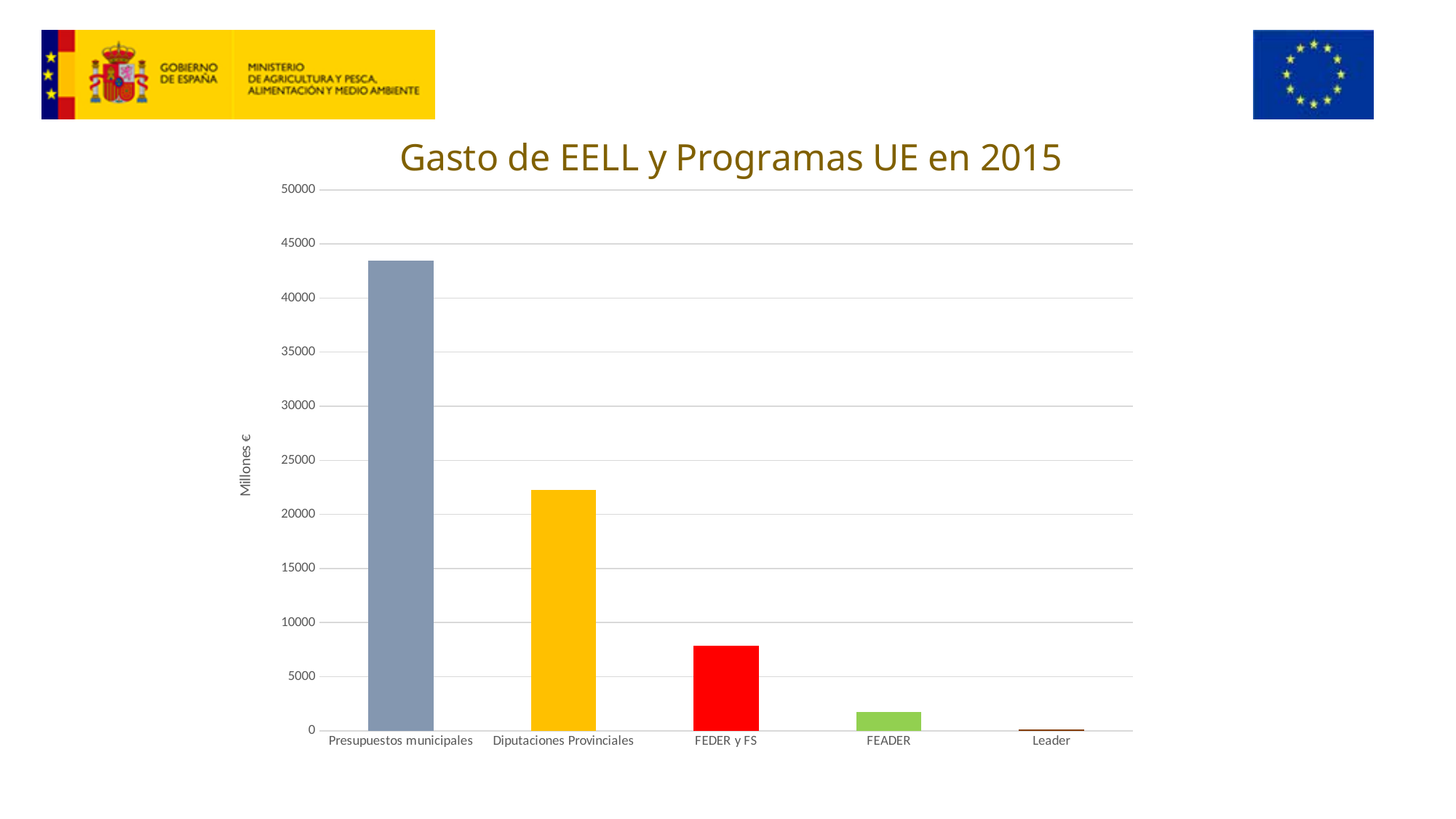
Is the value for FEADER greater or less than 5000? less What is the label of the vertical axis? Millones € Which category has the lowest value in the chart? Leader Is the value for Diputaciones Provinciales greater or less than 20000? greater What kind of chart is shown on the slide? bar chart Is the value for FEDER y FS greater or less than 10000? less Which is larger, the value for Diputaciones Provinciales or the value for FEDER y FS? Diputaciones Provinciales Which category has the highest value in the chart? Presupuestos municipales Do the values rise or fall from left to right along the x axis? fall How many categories are shown on the x axis of the chart? 5 What is the title of the chart? Gasto de EELL y Programas UE en 2015